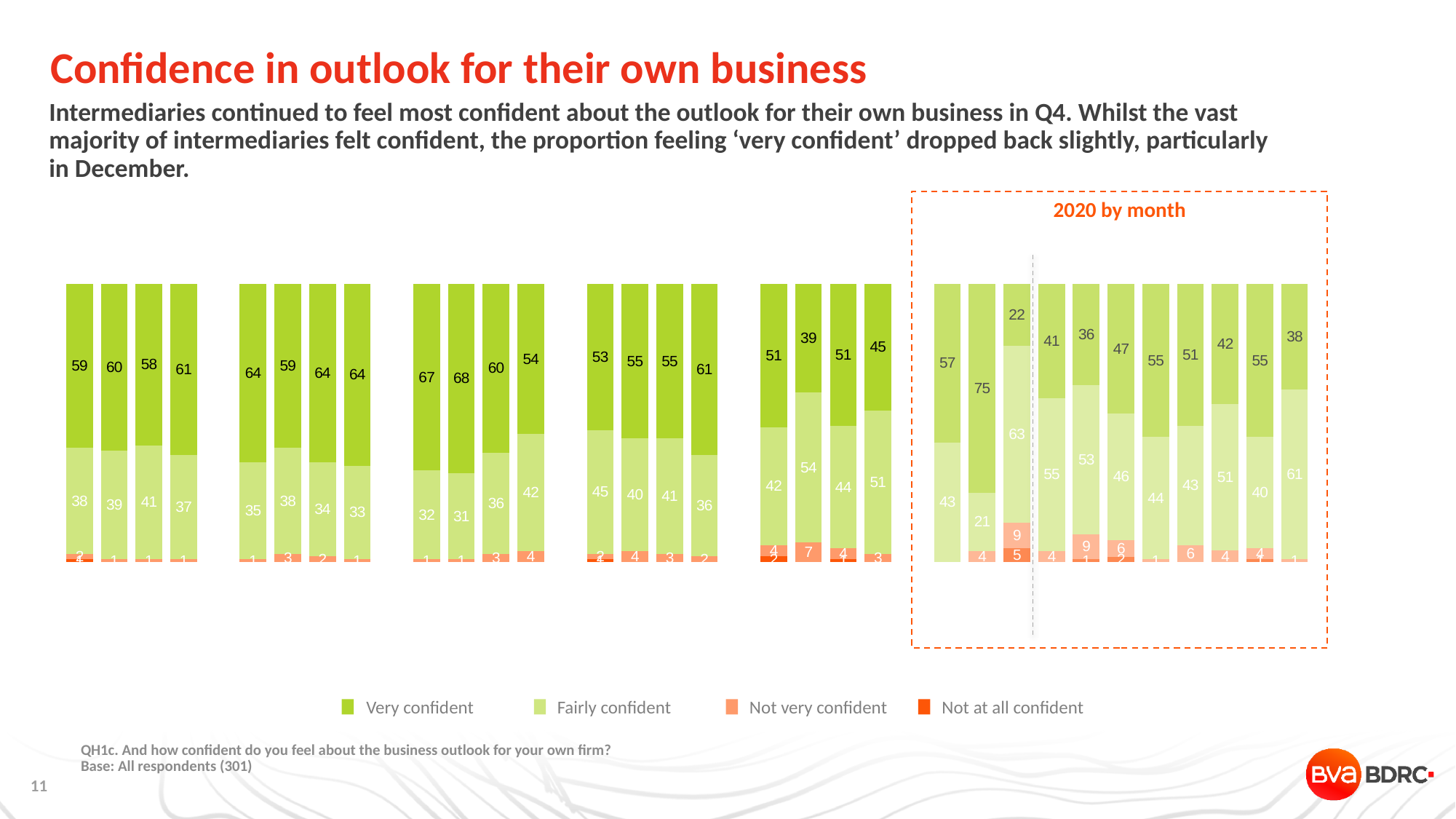
What are the four legend entries of the chart? Very confident, Fairly confident, Not very confident, Not at all confident In the last bar inside the '2020 by month' box, which is larger: the 'Very confident' or the 'Fairly confident' value? Fairly confident How many bars are plotted in the chart in total? 31 In the first bar inside the '2020 by month' box, what is the difference between the 'Very confident' and 'Fairly confident' values? 14 In the first bar inside the '2020 by month' box, what is the 'Very confident' value? 57 What is the lowest 'Very confident' value printed on any bar in the chart? 22 What is the highest 'Very confident' value printed on any bar in the chart? 75 What is the highest 'Fairly confident' value printed on any bar in the chart? 63 How many series does the legend list? 4 What kind of chart is shown on the slide? Stacked bar chart What is the title of the boxed section on the right of the chart? 2020 by month How many bars are inside the dashed '2020 by month' box? 11